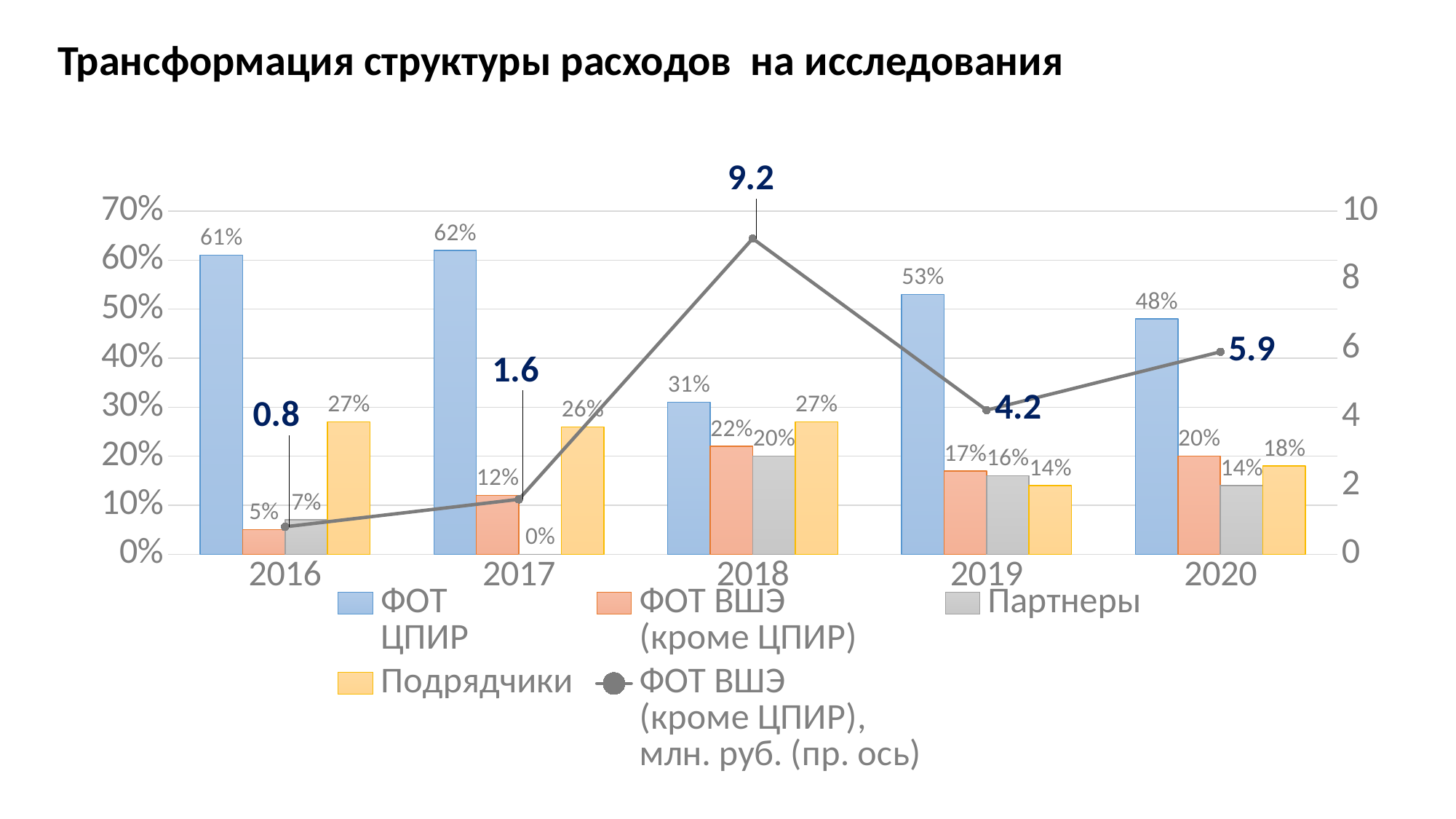
How many series does the legend list? 5 Which is larger in 2019: Партнеры or Подрядчики? Партнеры What is the value of Подрядчики in 2017? 26% What is the value of Партнеры in 2020? 14% In which year does the line series ФОТ ВШЭ (кроме ЦПИР), млн. руб. reach its highest value? 2018 How does the value of ФОТ ВШЭ (кроме ЦПИР) change from 2016 to 2018? It rises What is the title of the slide? Трансформация структуры расходов на исследования In which year is the value of ФОТ ЦПИР the lowest? 2018 What is the difference between the ФОТ ЦПИР values in 2017 and 2020? 14% How many years are shown on the x axis? 5 What is the value of ФОТ ЦПИР in 2018? 31% What is the value of the line series ФОТ ВШЭ (кроме ЦПИР), млн. руб. (пр. ось) in 2019? 4.2